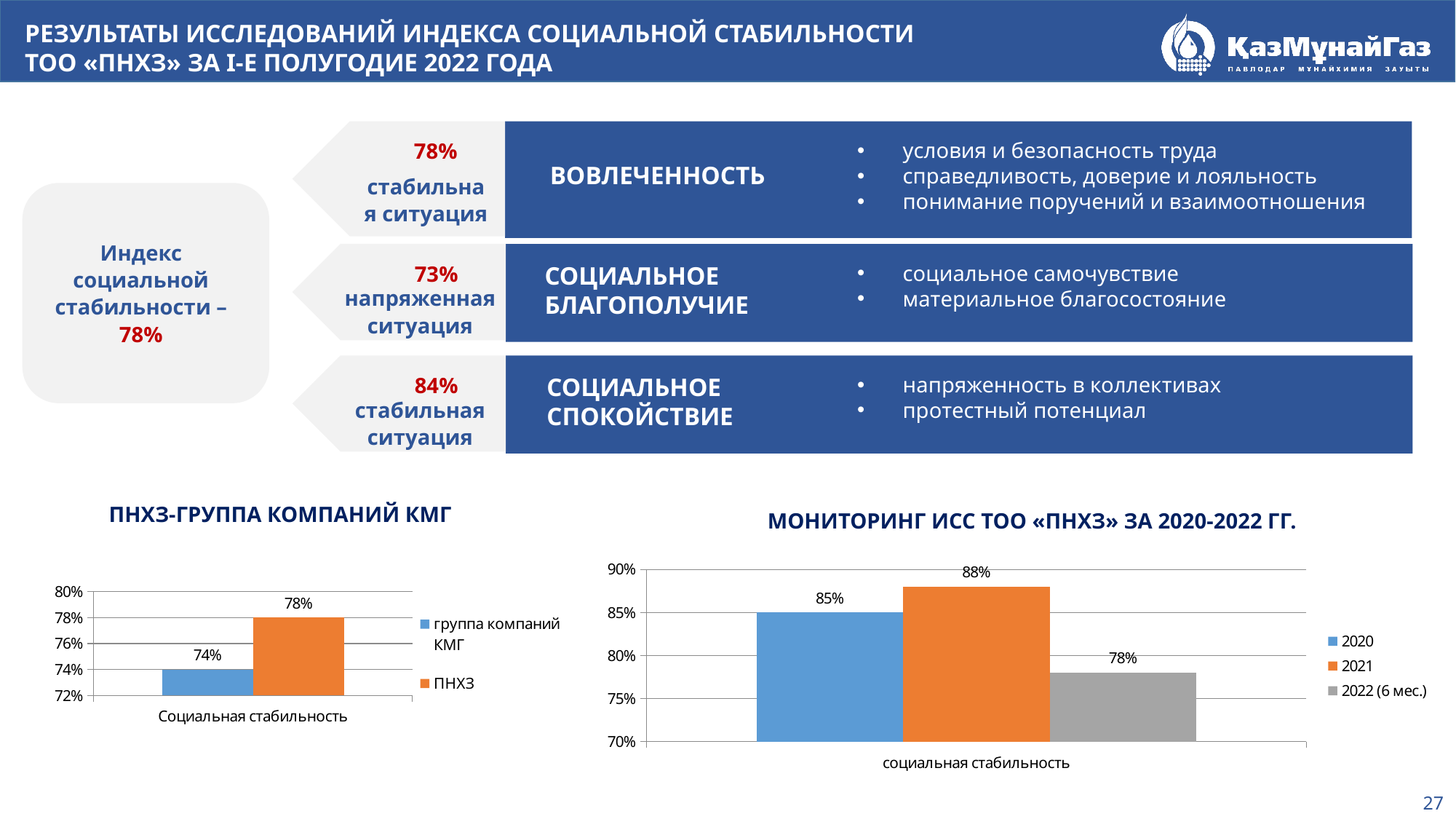
In the chart titled «ПНХЗ-ГРУППА КОМПАНИЙ КМГ», how many series does the legend list? 2 In the chart titled «ПНХЗ-ГРУППА КОМПАНИЙ КМГ», what is the value for «группа компаний КМГ»? 74% In the chart titled «ПНХЗ-ГРУППА КОМПАНИЙ КМГ», which series has the larger value, «ПНХЗ» or «группа компаний КМГ»? ПНХЗ In the chart titled «МОНИТОРИНГ ИСС ТОО «ПНХЗ» ЗА 2020-2022 ГГ.», what is the difference between the 2021 value and the 2022 (6 мес.) value? 10% In the chart titled «МОНИТОРИНГ ИСС ТОО «ПНХЗ» ЗА 2020-2022 ГГ.», which year has the highest value? 2021 In the chart titled «МОНИТОРИНГ ИСС ТОО «ПНХЗ» ЗА 2020-2022 ГГ.», what is the value for 2021? 88% In the chart titled «МОНИТОРИНГ ИСС ТОО «ПНХЗ» ЗА 2020-2022 ГГ.», what is the value for 2020? 85% In the chart titled «МОНИТОРИНГ ИСС ТОО «ПНХЗ» ЗА 2020-2022 ГГ.», how many series does the legend list? 3 What kind of chart is the one titled «МОНИТОРИНГ ИСС ТОО «ПНХЗ» ЗА 2020-2022 ГГ.»? Bar chart In the chart titled «ПНХЗ-ГРУППА КОМПАНИЙ КМГ», what is the value for «ПНХЗ»? 78% In the chart titled «ПНХЗ-ГРУППА КОМПАНИЙ КМГ», what is the difference between the «ПНХЗ» value and the «группа компаний КМГ» value? 4% In the chart titled «МОНИТОРИНГ ИСС ТОО «ПНХЗ» ЗА 2020-2022 ГГ.», which year has the lowest value? 2022 (6 мес.)